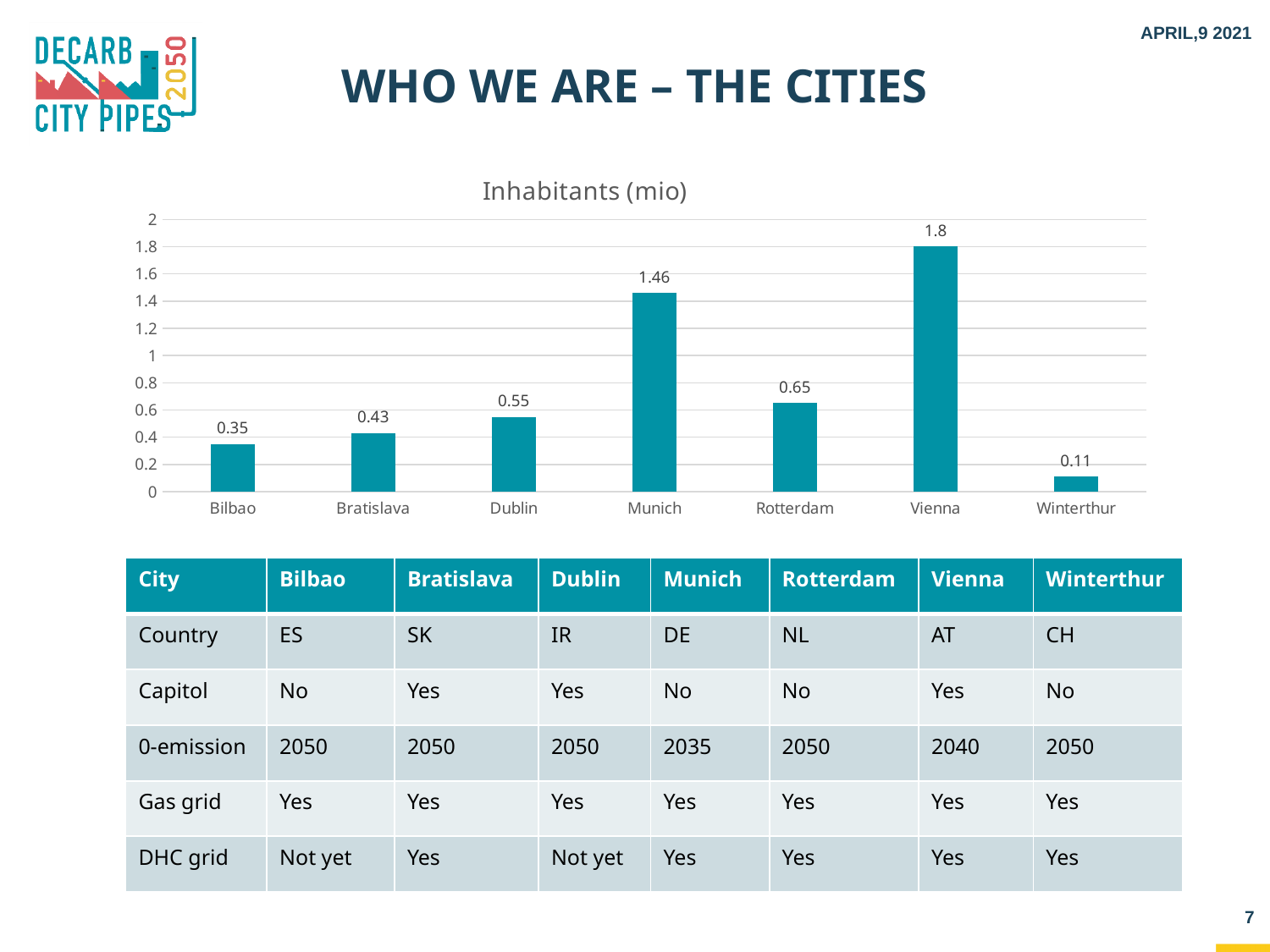
How many cities are shown in the Inhabitants (mio) chart? 7 What is the difference between the values for Dublin and Bilbao in the Inhabitants (mio) chart? 0.2 Which city has the highest value in the Inhabitants (mio) chart? Vienna Which city has the lowest value in the Inhabitants (mio) chart? Winterthur What is the difference between the values for Vienna and Munich in the Inhabitants (mio) chart? 0.34 Is the value for Munich in the Inhabitants (mio) chart greater or less than 1.2? greater What is the title of the chart on the slide? Inhabitants (mio) Which has a larger value in the Inhabitants (mio) chart, Bratislava or Rotterdam? Rotterdam What is the value for Winterthur in the Inhabitants (mio) chart? 0.11 What is the value for Munich in the Inhabitants (mio) chart? 1.46 What is the value for Rotterdam in the Inhabitants (mio) chart? 0.65 What kind of chart is the Inhabitants (mio) chart? bar chart